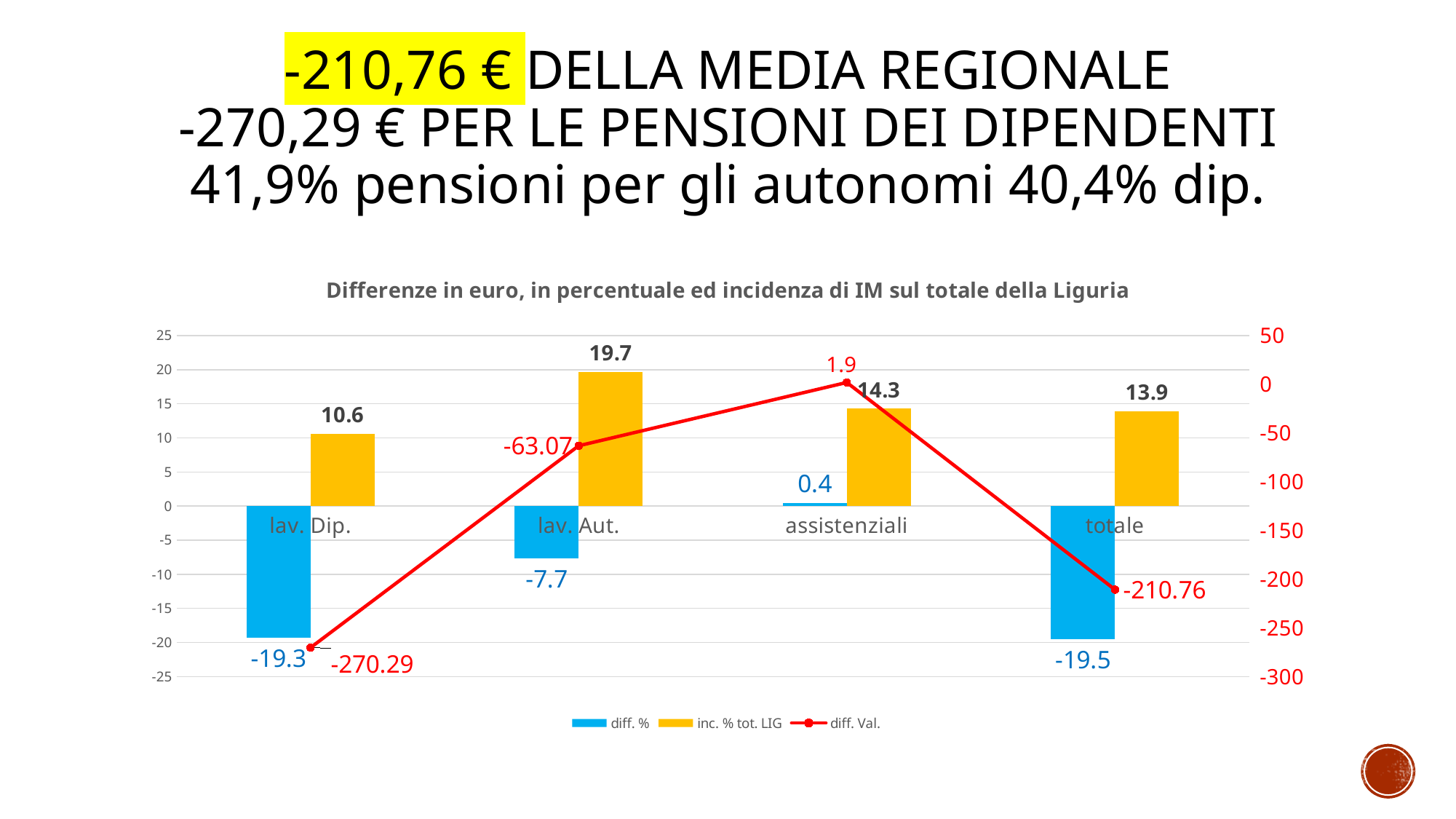
Which category has the highest value for inc. % tot. LIG? lav. Aut. How many categories are shown on the x axis? 4 What kind of chart is this? Combined bar and line chart What is the title of the chart? Differenze in euro, in percentuale ed incidenza di IM sul totale della Liguria What is the value of diff. % for lav. Dip.? -19.3 What is the value of diff. Val. for totale? -210.76 What is the value of diff. Val. for assistenziali? 1.9 Which is larger, the diff. % value for lav. Aut. or for assistenziali? assistenziali What is the difference between the inc. % tot. LIG values for lav. Aut. and lav. Dip.? 9.1 Which category has the lowest value for diff. Val.? lav. Dip. How many series does the legend list? 3 What is the value of inc. % tot. LIG for lav. Aut.? 19.7